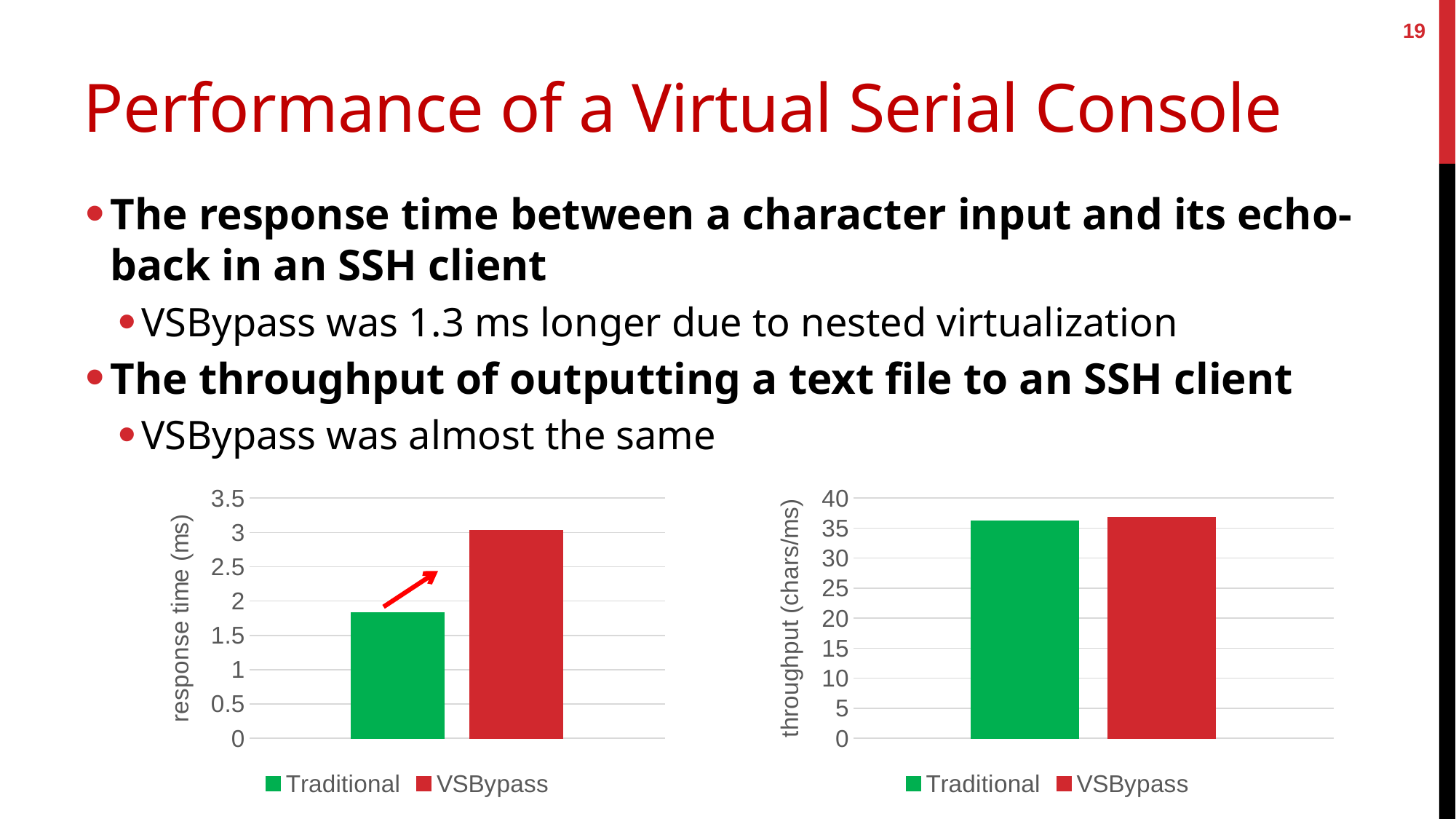
How many series does the legend of the left chart list? 2 In the left chart (response time), is the value for VSBypass greater or less than 2.5? greater How many series does the legend of the right chart list? 2 In the right chart (throughput), is the value for VSBypass greater or less than 40? less In the left chart (response time), which series has the lowest value? Traditional In the left chart (response time), is the value for Traditional greater or less than 2? less What is the y-axis label of the right chart? throughput (chars/ms) In the left chart (response time), which series has the higher value, Traditional or VSBypass? VSBypass What kind of chart is the left chart on the slide? bar chart What kind of chart is the right chart on the slide? bar chart In the left chart, what colour are the VSBypass bars? red